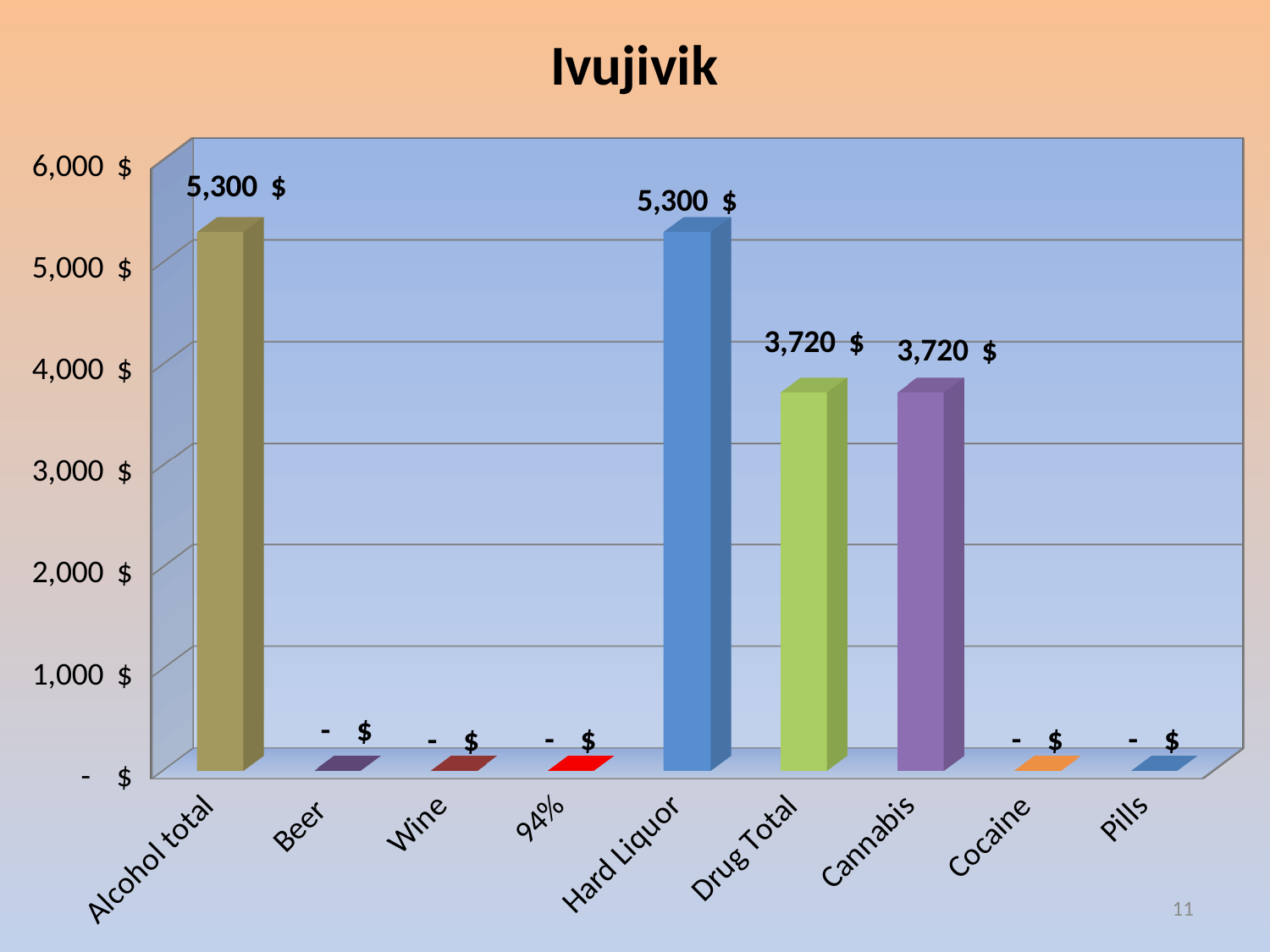
What is the value for Cannabis? 3,720 $ What is the difference between the values for Alcohol total and Drug Total? 1,580 $ What is the title of the chart? Ivujivik What is the value for Alcohol total? 5,300 $ Which is larger, the value for Hard Liquor or the value for Cannabis? Hard Liquor What is the value for Drug Total? 3,720 $ What is the value for Hard Liquor? 5,300 $ How many categories have a value shown as "- $"? 5 What is the value shown for Beer? - $ What kind of chart is shown on the slide? Bar chart Is the value for Drug Total greater or less than 3,000 $? greater How many categories are shown on the x axis? 9